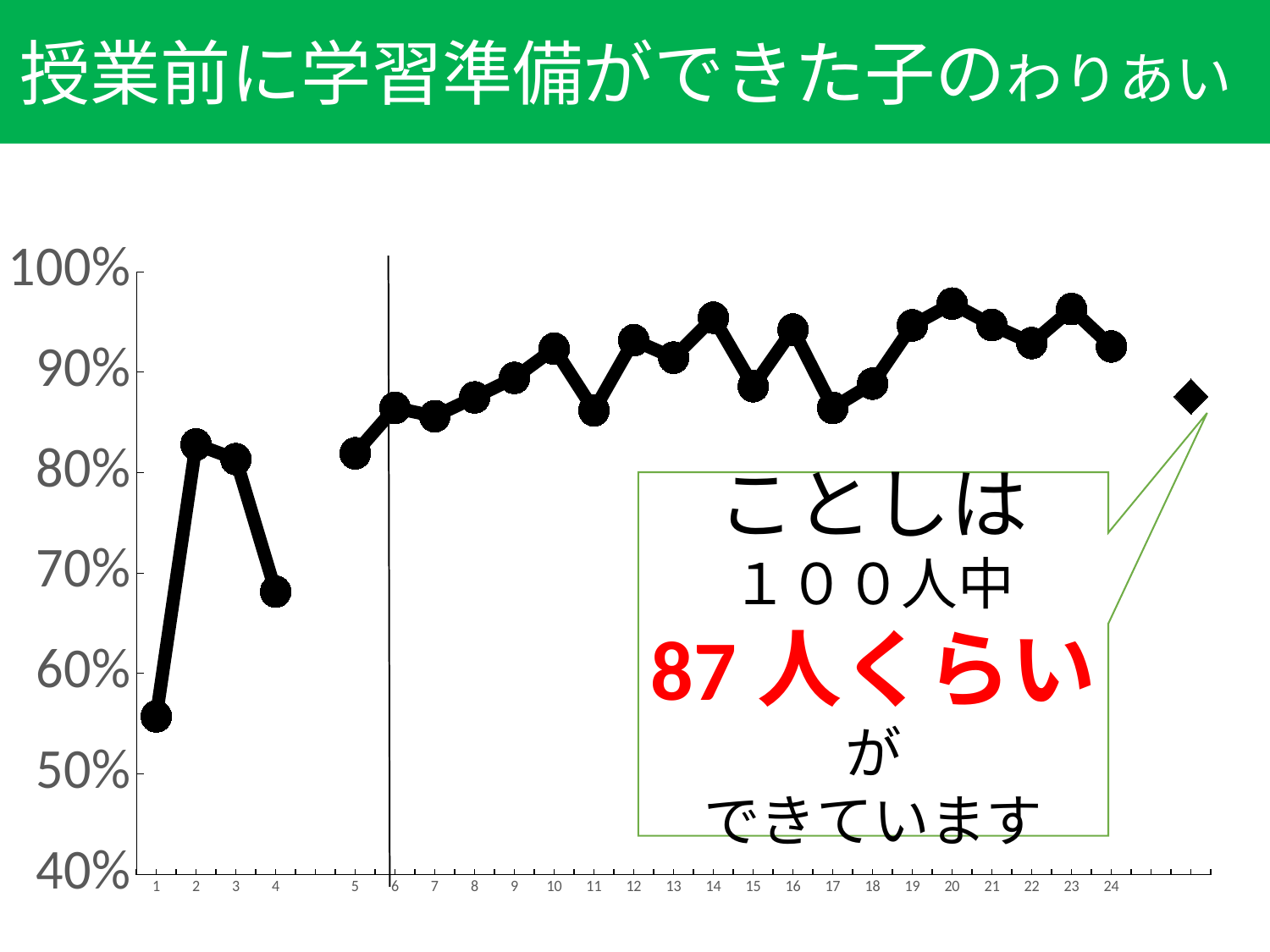
Is the value at point 2 greater or less than 80%? greater Is the value at point 20 greater or less than 90%? greater Is the value at point 4 greater or less than 80%? less Which is larger, the value at point 1 or the value at point 20? point 20 Does the line rise or fall from point 1 to point 2? rise Which is larger, the value at point 4 or the value at point 5? point 5 Which point has the lowest value on the chart? 1 What is the title of the chart on the slide? 授業前に学習準備ができた子のわりあい What kind of chart is shown on the slide? line chart What is the lowest value shown on the y axis? 40%